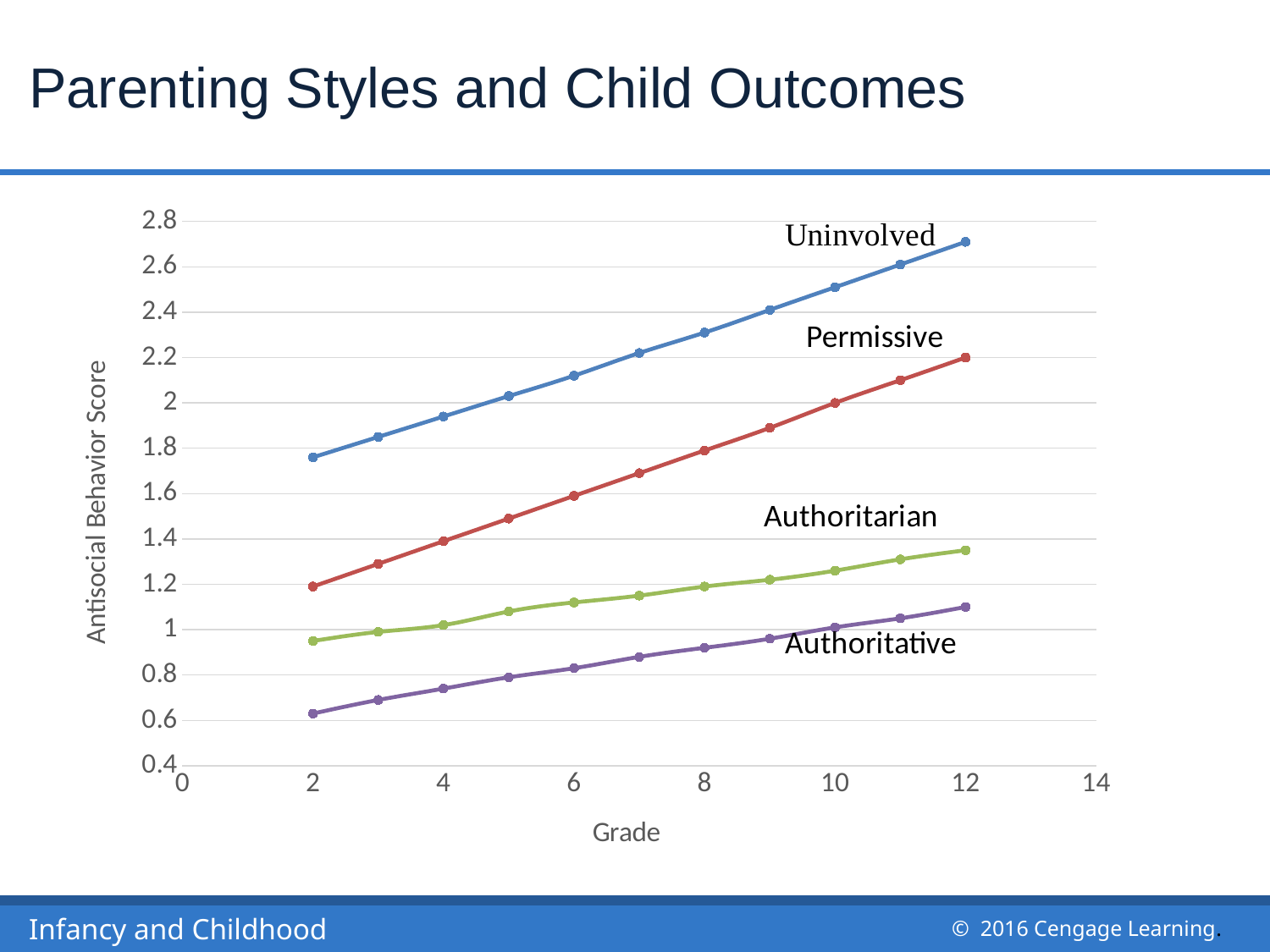
What is the label of the y axis? Antisocial Behavior Score Do the antisocial behavior scores rise or fall as grade increases for the Permissive line? rise How many data points does the Uninvolved line have? 11 What kind of chart is shown on the slide? line chart How many parenting-style lines are plotted on the chart? 4 Is the Authoritative value at grade 12 greater or less than 1? greater Which parenting style has the highest antisocial behavior score at grade 12? Uninvolved Is the Uninvolved value at grade 12 greater or less than 2.6? greater Is the Authoritarian value at grade 2 greater or less than 1? less At grade 8, which line has the larger value, Permissive or Authoritarian? Permissive Which parenting style has the lowest antisocial behavior score at grade 2? Authoritative